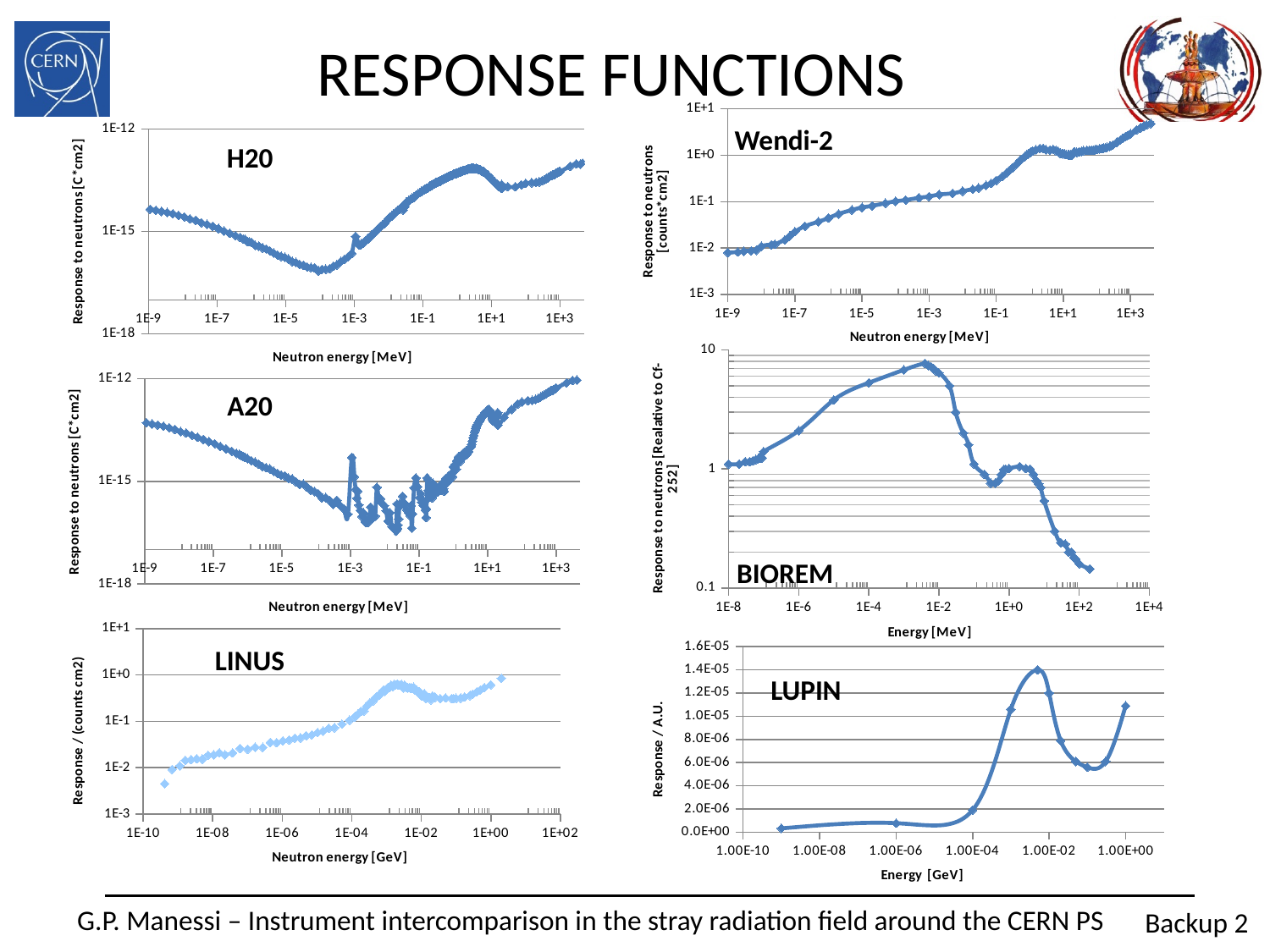
How many charts are shown on the slide? 6 In the A20 chart, is the response at a neutron energy of 1E-9 MeV greater or less than 1E-15? greater In the Wendi-2 chart, does the response generally rise or fall as neutron energy increases from 1E-9 to 1E+3 MeV? rise What kind of chart is the H20 chart? line chart In the BIOREM chart, which is larger: the response at an energy of 1E-2 MeV or at 1E+0 MeV? 1E-2 MeV In the Wendi-2 chart, is the response at a neutron energy of 1E+3 MeV greater or less than 1E+0? greater In the LUPIN chart, is the peak response greater or less than 1.2E-05? greater In the H20 chart, does the response rise or fall as neutron energy increases from 1E-9 to 1E-5 MeV? fall What is the y-axis title of the Wendi-2 chart? Response to neutrons [counts*cm2]